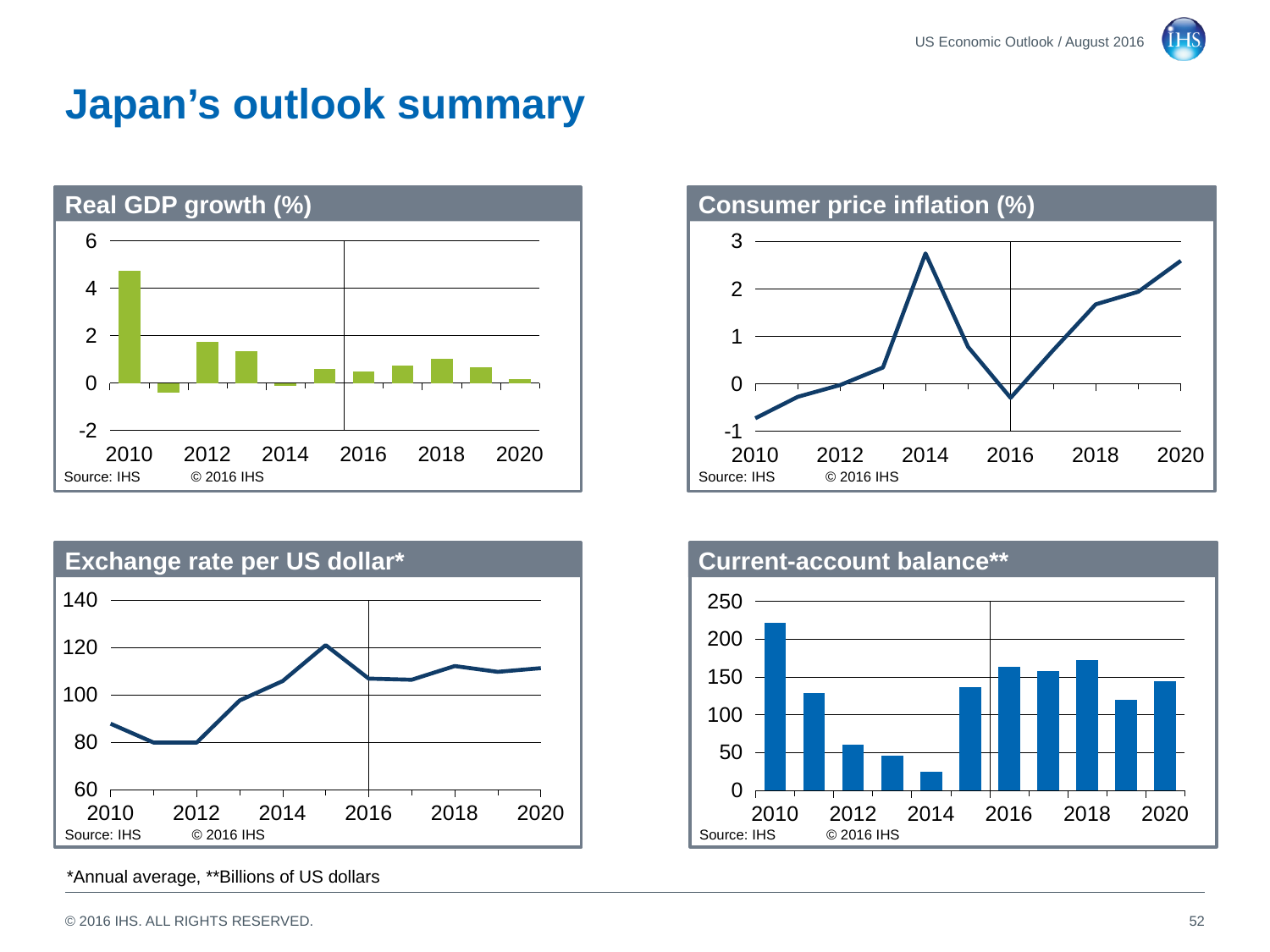
In the "Current-account balance**" chart, which is larger, the value for 2016 or the value for 2019? 2016 In the "Real GDP growth (%)" chart, which year has the lowest value? 2011 In the "Real GDP growth (%)" chart, is the value for 2010 greater or less than 4? greater What kind of chart is the "Consumer price inflation (%)" chart? line chart In the "Consumer price inflation (%)" chart, which year has the highest value? 2014 What kind of chart is the "Real GDP growth (%)" chart? bar chart In the "Real GDP growth (%)" chart, which year has the highest value? 2010 In the "Consumer price inflation (%)" chart, is the value for 2016 greater or less than 0? less How many years are plotted in the "Current-account balance**" chart? 11 In the "Current-account balance**" chart, which year has the lowest value? 2014 In the "Exchange rate per US dollar*" chart, is the value for 2010 greater or less than 100? less In the "Exchange rate per US dollar*" chart, which year has the highest value? 2015